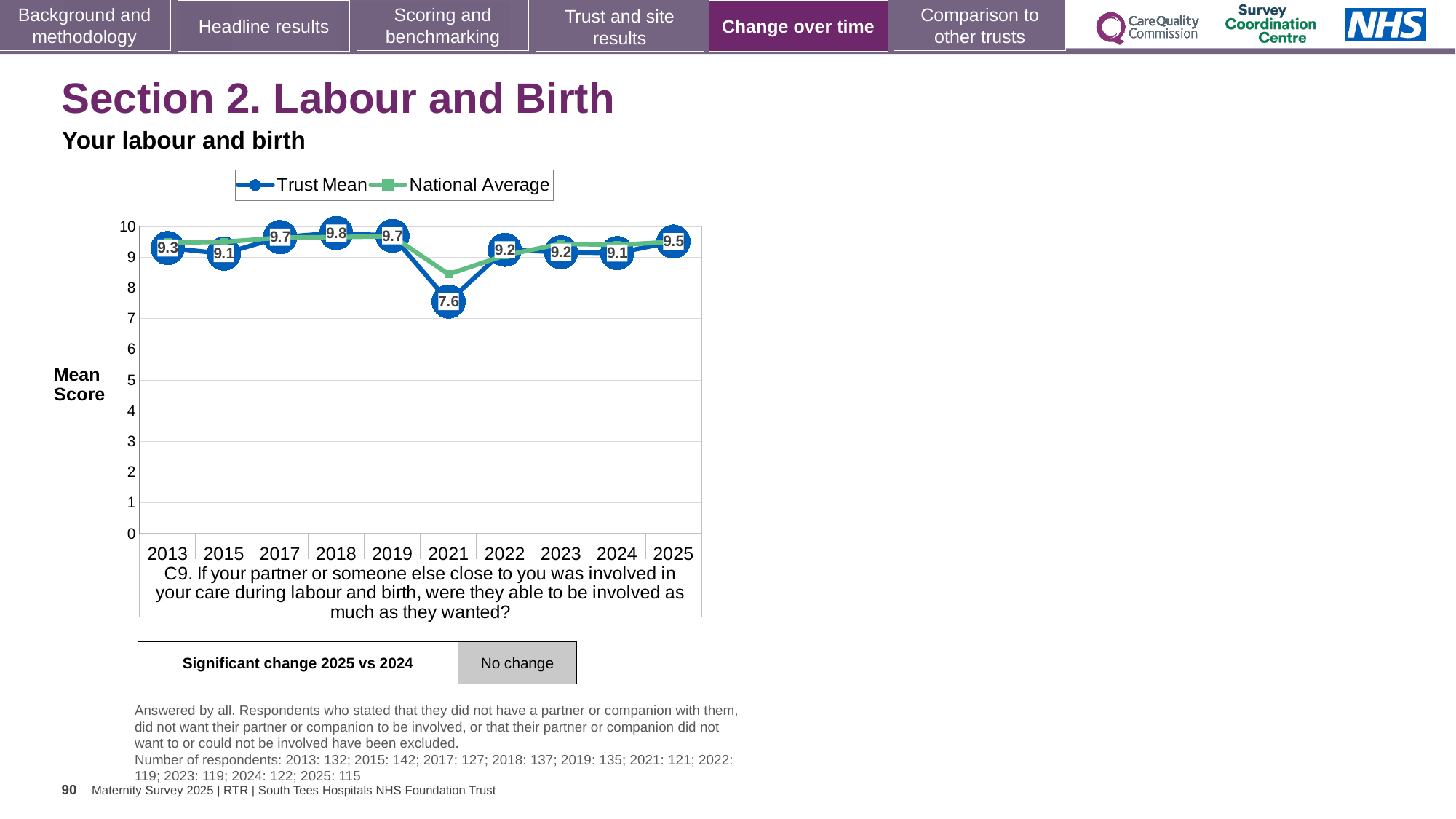
How many series does the legend list? 2 What is the Trust Mean value for 2021? 7.6 In which year is the Trust Mean highest? 2018 What kind of chart is shown on the slide? Line chart Which year has a larger Trust Mean, 2017 or 2024? 2017 Is the National Average value for 2021 greater or less than 8? greater What is the Trust Mean value for 2013? 9.3 How many years are plotted on the x axis? 10 In which year is the Trust Mean lowest? 2021 What is the difference between the Trust Mean in 2018 and in 2021? 2.2 Does the Trust Mean rise or fall from 2019 to 2021? Fall What is the Trust Mean value for 2025? 9.5